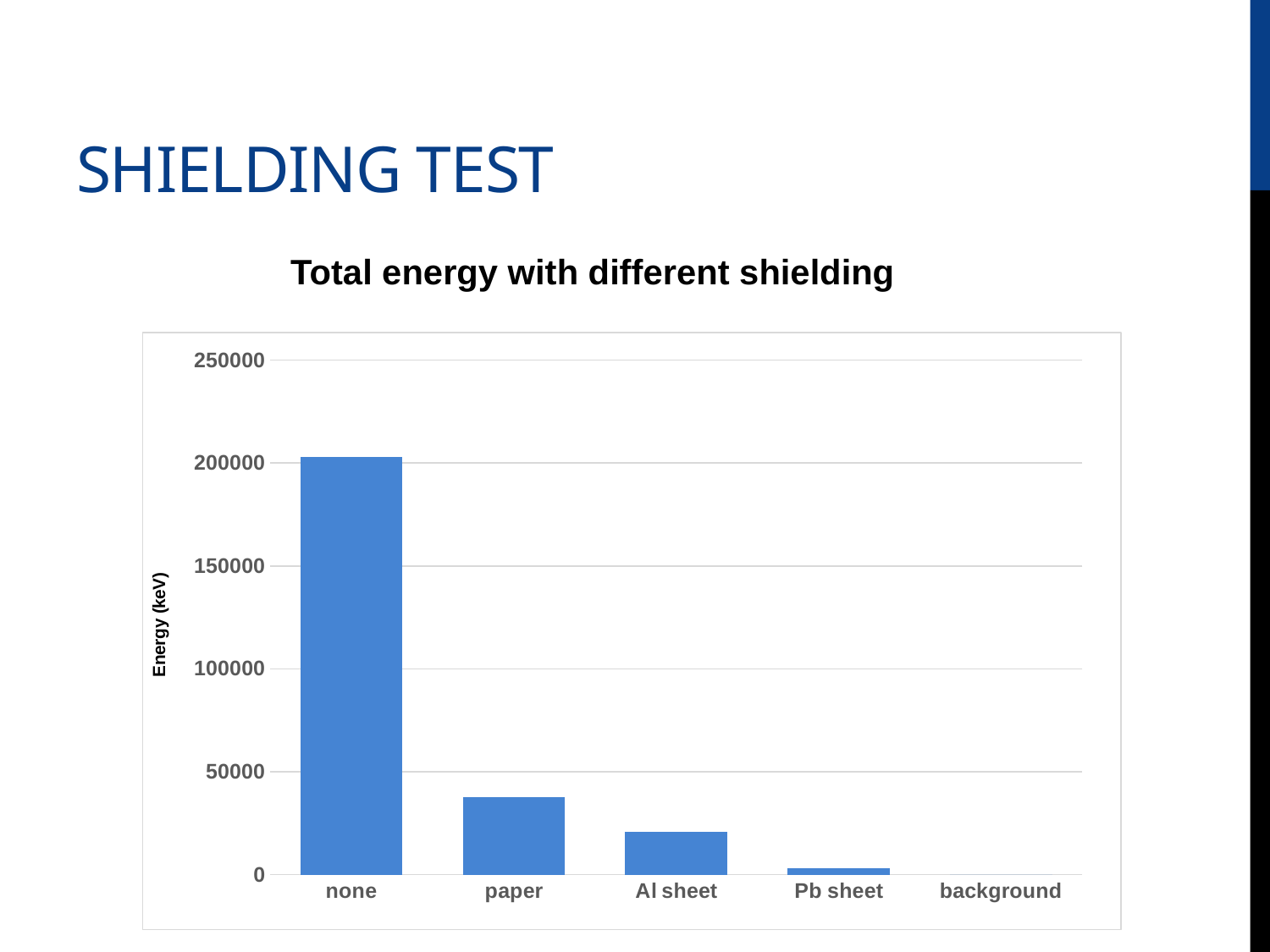
Which has a higher total energy, paper or Al sheet? paper What kind of chart is shown on the slide? bar chart Do the values rise or fall moving from left to right along the x axis? fall Is the value for paper greater or less than 50000? less Which has a higher total energy, Pb sheet or Al sheet? Al sheet Is the value for none greater or less than 150000? greater How many shielding categories are shown on the x axis? 5 Which shielding category has the highest total energy? none What is the title of the chart? Total energy with different shielding Which shielding category has the lowest total energy? background What is the label of the y axis? Energy (keV) Is the value for Al sheet greater or less than 50000? less